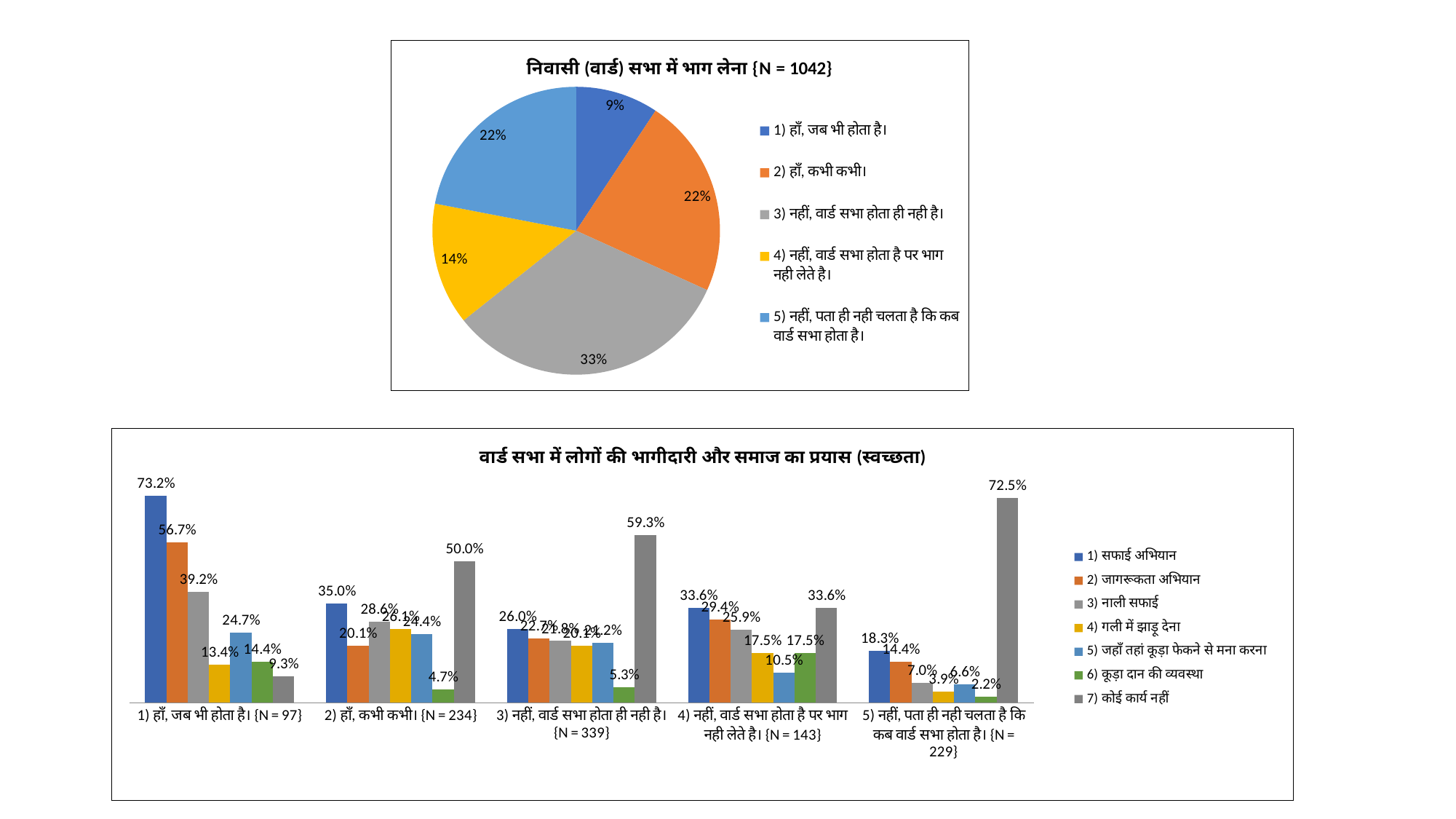
In the bar chart titled 'वार्ड सभा में लोगों की भागीदारी और समाज का प्रयास (स्वच्छता)', what is the difference between '1) सफाई अभियान' and '2) जागरूकता अभियान' for the category '1) हाँ, जब भी होता है। {N = 97}'? 16.5% In the bar chart titled 'वार्ड सभा में लोगों की भागीदारी और समाज का प्रयास (स्वच्छता)', which is larger for the category '4) नहीं, वार्ड सभा होता है पर भाग नही लेते है। {N = 143}': '2) जागरूकता अभियान' or '3) नाली सफाई'? 2) जागरूकता अभियान In the pie chart titled 'निवासी (वार्ड) सभा में भाग लेना {N = 1042}', which category has the smallest slice? 1) हाँ, जब भी होता है। In the pie chart titled 'निवासी (वार्ड) सभा में भाग लेना {N = 1042}', what share does '3) नहीं, वार्ड सभा होता ही नही है।' have? 33% In the pie chart titled 'निवासी (वार्ड) सभा में भाग लेना {N = 1042}', how many slices are there? 5 In the bar chart titled 'वार्ड सभा में लोगों की भागीदारी और समाज का प्रयास (स्वच्छता)', how many series does the legend list? 7 What type of chart is the lower chart on the slide? Bar chart In the bar chart titled 'वार्ड सभा में लोगों की भागीदारी और समाज का प्रयास (स्वच्छता)', which series has the highest value for the category '2) हाँ, कभी कभी। {N = 234}'? 7) कोई कार्य नहीं In the bar chart titled 'वार्ड सभा में लोगों की भागीदारी और समाज का प्रयास (स्वच्छता)', what is the value of '7) कोई कार्य नहीं' for the category '5) नहीं, पता ही नही चलता है कि कब वार्ड सभा होता है। {N = 229}'? 72.5% In the pie chart titled 'निवासी (वार्ड) सभा में भाग लेना {N = 1042}', what is the share for '4) नहीं, वार्ड सभा होता है पर भाग नही लेते है।'? 14% In the bar chart titled 'वार्ड सभा में लोगों की भागीदारी और समाज का प्रयास (स्वच्छता)', what is the value of '1) सफाई अभियान' for the category '1) हाँ, जब भी होता है। {N = 97}'? 73.2% In the bar chart titled 'वार्ड सभा में लोगों की भागीदारी और समाज का प्रयास (स्वच्छता)', what is the value of '6) कूड़ा दान की व्यवस्था' for the category '3) नहीं, वार्ड सभा होता ही नही है। {N = 339}'? 5.3%